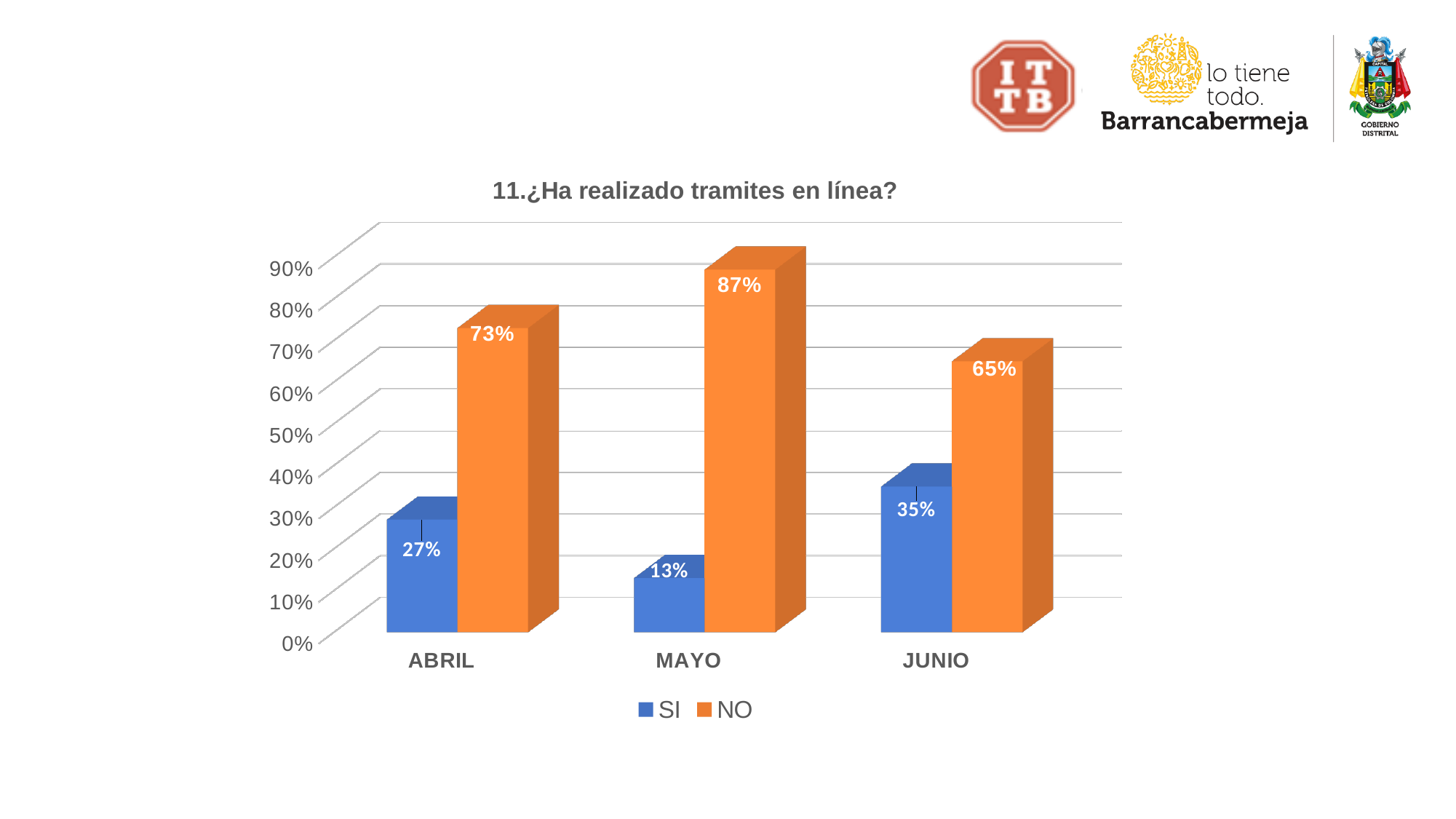
What is the title of the chart? 11.¿Ha realizado tramites en línea? How many series does the legend list? 2 Which is larger in JUNIO, SI or NO? NO Which month has the highest value for NO? MAYO What is the value for NO in JUNIO? 65% Which month has the lowest value for SI? MAYO What is the value for SI in JUNIO? 35% What is the value for SI in ABRIL? 27% What is the value for NO in MAYO? 87% What kind of chart is shown? Bar chart What is the difference between NO and SI in ABRIL? 46% How many months are shown on the x axis? 3